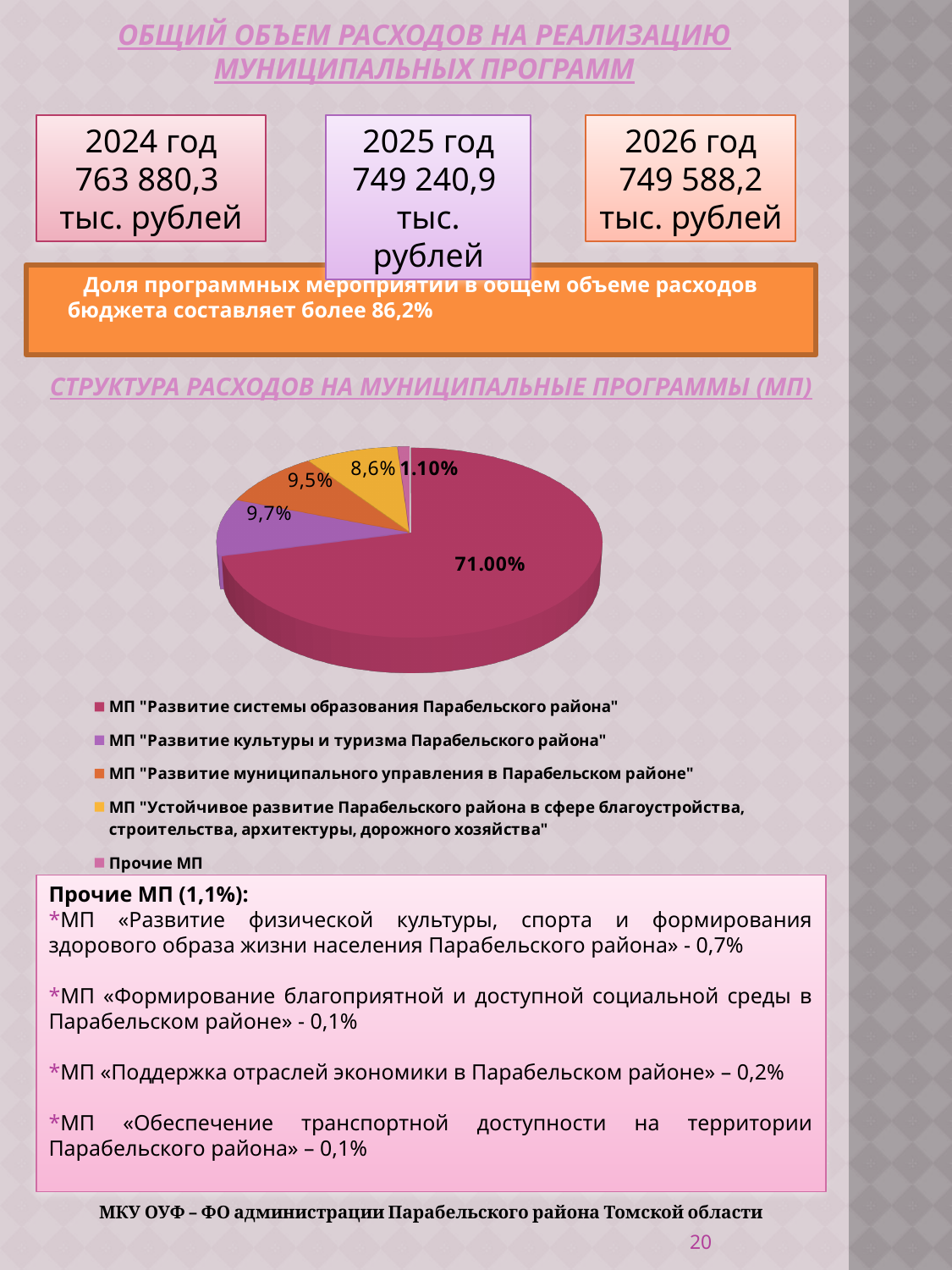
Which is larger in the pie chart: the slice for МП "Развитие культуры и туризма Парабельского района" or the slice for МП "Устойчивое развитие Парабельского района в сфере благоустройства, строительства, архитектуры, дорожного хозяйства"? МП "Развитие культуры и туризма Парабельского района" How many slices does the pie chart have? 5 How many entries does the legend of the pie chart list? 5 What colour is the slice for МП "Развитие системы образования Парабельского района" in the pie chart? magenta (dark pink) What share of the pie does "Прочие МП" have? 1.10% Which category has the smallest slice of the pie chart? Прочие МП Which category has the largest slice of the pie chart? МП "Развитие системы образования Парабельского района" What share of the pie does МП "Развитие системы образования Парабельского района" have? 71.00% What share of the pie does МП "Развитие муниципального управления в Парабельском районе" have? 9,5% What kind of chart is shown under the heading "СТРУКТУРА РАСХОДОВ НА МУНИЦИПАЛЬНЫЕ ПРОГРАММЫ (МП)"? pie chart